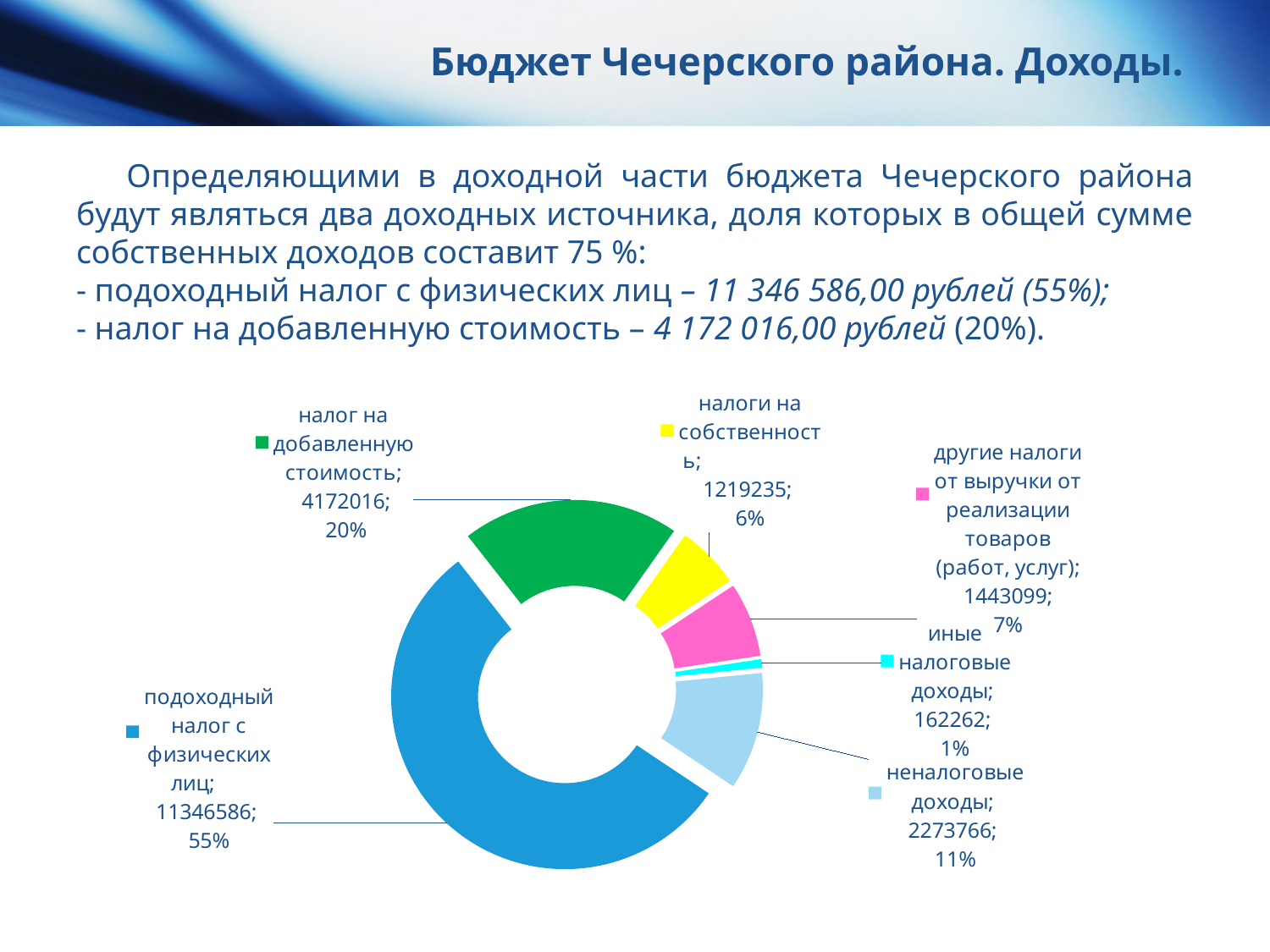
Which is larger: другие налоги от выручки от реализации товаров (работ, услуг) or налоги на собственность? другие налоги от выручки от реализации товаров (работ, услуг) How many categories does the doughnut chart show? 6 Which category has the smallest value? иные налоговые доходы What share of the chart does иные налоговые доходы represent? 1% What is the value for подоходный налог с физических лиц? 11346586 What kind of chart is shown on the slide? Doughnut (pie) chart What share of the chart does налоги на собственность represent? 6% What is the value for неналоговые доходы? 2273766 What share of the chart does налог на добавленную стоимость represent? 20% What is the difference between the values for налог на добавленную стоимость and неналоговые доходы? 1898250 Which category has the largest value? подоходный налог с физических лиц What is the title of the slide containing the chart? Бюджет Чечерского района. Доходы.